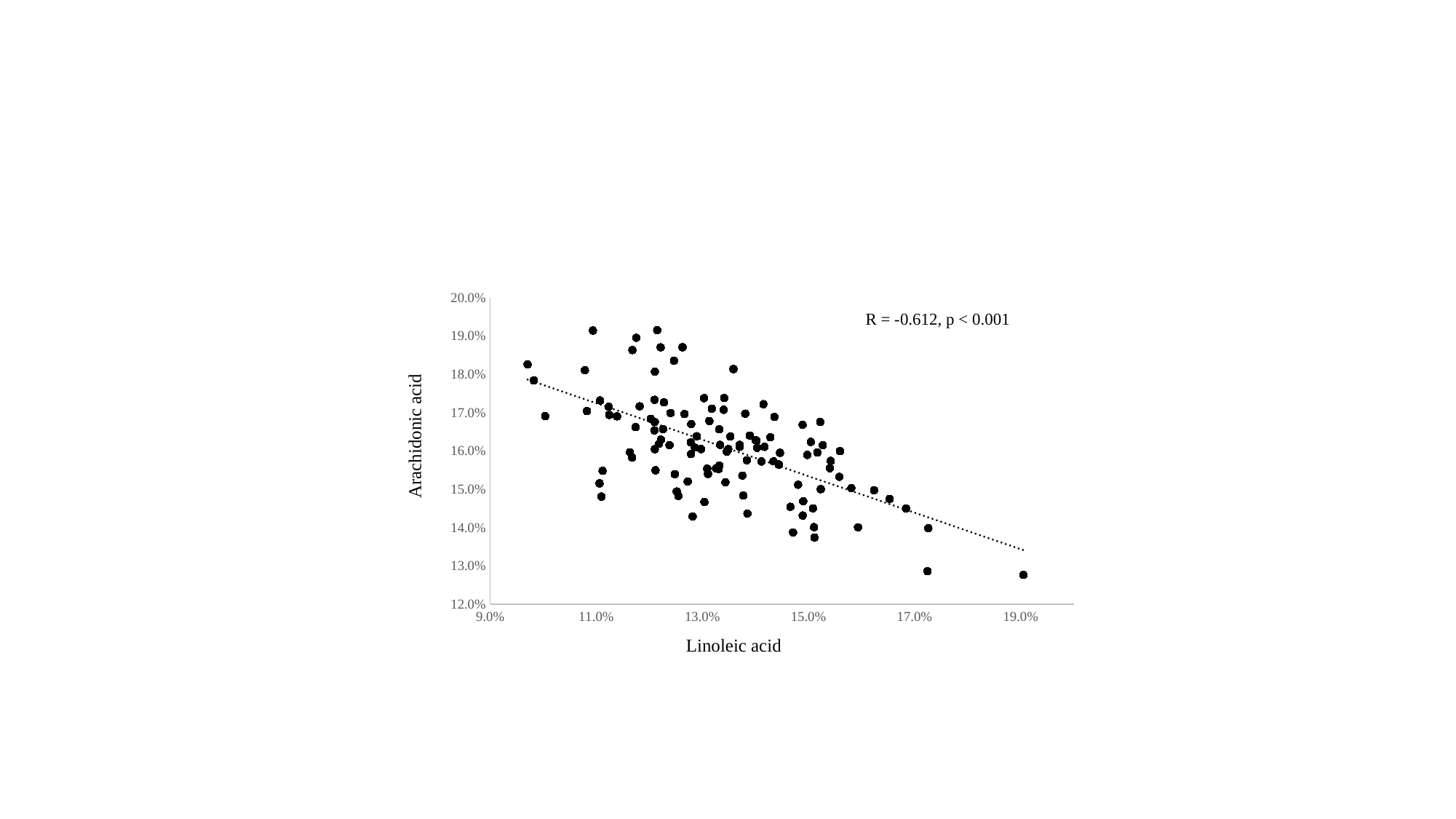
As linoleic acid increases along the x axis, do the arachidonic acid values generally rise or fall? fall For the point with the lowest linoleic acid value (near 9.7%), is its arachidonic acid value greater or less than 17.0%? greater What kind of chart is shown on the slide? scatter chart What is the title of the x axis? Linoleic acid What p-value is printed on the chart? p < 0.001 Is the correlation between linoleic acid and arachidonic acid shown on the chart positive or negative? negative For the point with the highest linoleic acid value (near 19.0%), is its arachidonic acid value greater or less than 14.0%? less What is the title of the y axis? Arachidonic acid What correlation coefficient R is printed on the chart? R = -0.612